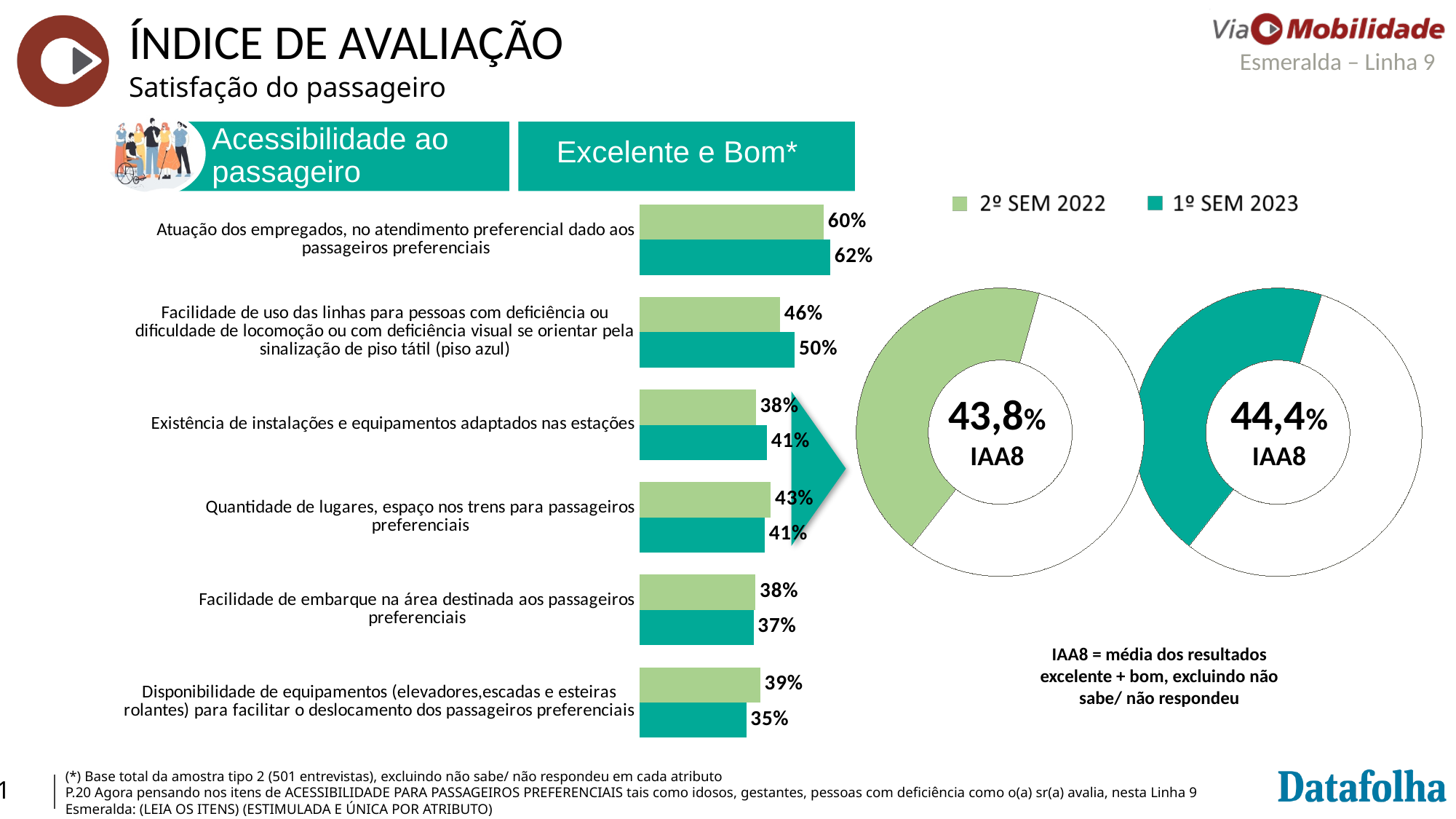
In the bar chart, what is the 1º SEM 2023 value for 'Atuação dos empregados, no atendimento preferencial dado aos passageiros preferenciais'? 62% How many series does the legend of the bar chart list? 2 In the right donut chart (1º SEM 2023), what is the IAA8 value? 44,4% How many categories does the bar chart show? 6 In the bar chart, what is the difference between the 1º SEM 2023 and 2º SEM 2022 values for 'Facilidade de uso das linhas para pessoas com deficiência...' (piso tátil)? 4 percentage points In the bar chart, what is the 2º SEM 2022 value for 'Facilidade de uso das linhas para pessoas com deficiência ou dificuldade de locomoção ou com deficiência visual se orientar pela sinalização de piso tátil (piso azul)'? 46% In the bar chart, which category has the lowest 1º SEM 2023 value? Disponibilidade de equipamentos (elevadores, escadas e esteiras rolantes) para facilitar o deslocamento dos passageiros preferenciais In the bar chart, for 'Quantidade de lugares, espaço nos trens para passageiros preferenciais', which is larger: the 2º SEM 2022 value or the 1º SEM 2023 value? 2º SEM 2022 In the left donut chart (2º SEM 2022), what is the IAA8 value? 43,8% In the bar chart, what is the 1º SEM 2023 value for 'Disponibilidade de equipamentos (elevadores, escadas e esteiras rolantes) para facilitar o deslocamento dos passageiros preferenciais'? 35% What kind of chart is used to show the attribute results on the left of the slide? Bar chart In the bar chart, which category has the highest 1º SEM 2023 value? Atuação dos empregados, no atendimento preferencial dado aos passageiros preferenciais